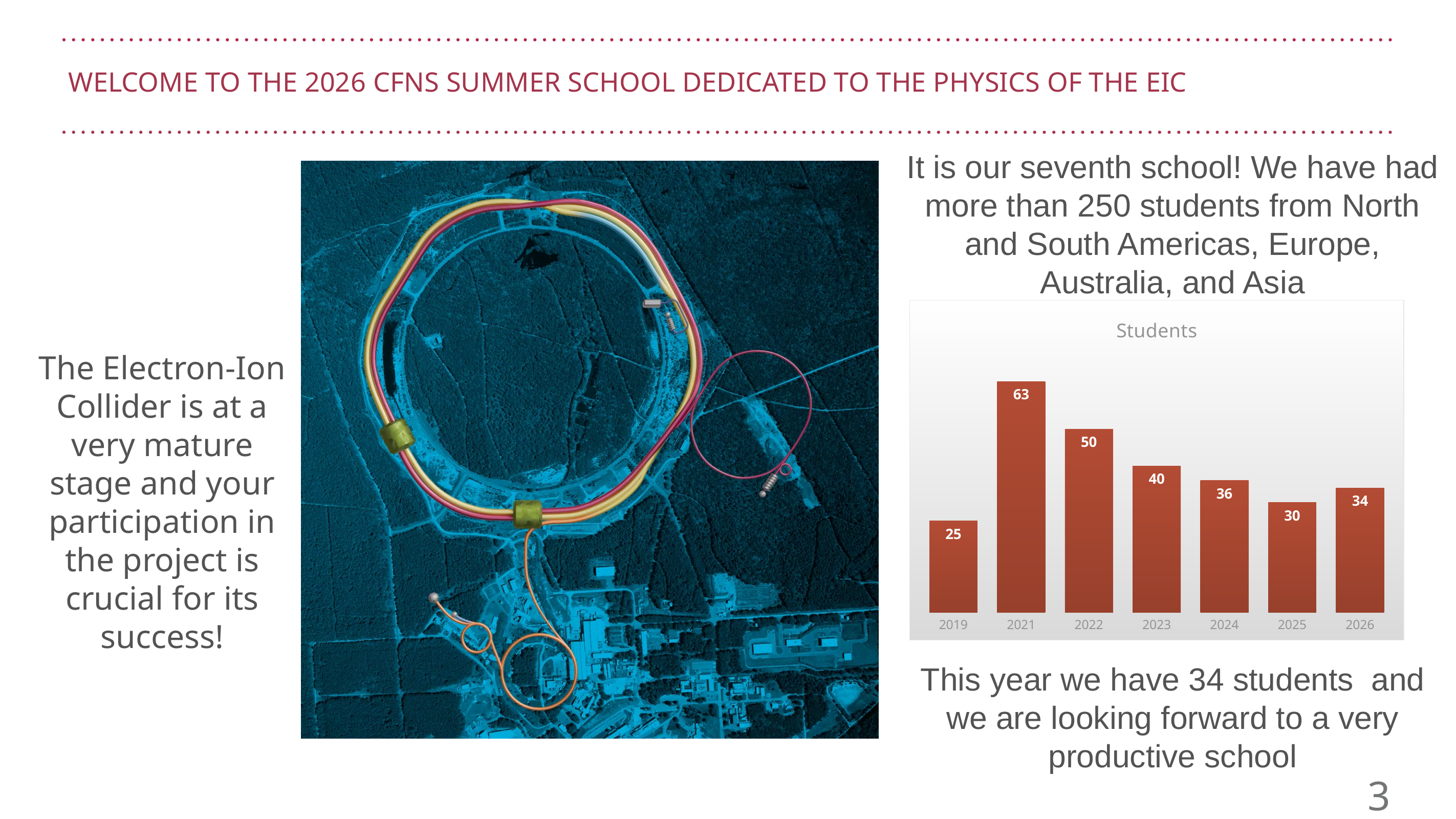
What is the title of the chart on the slide? Students Which year has the lowest value in the Students chart? 2019 How many years are shown in the Students chart? 7 What is the value for 2021 in the Students chart? 63 What is the difference between the values for 2026 and 2025 in the Students chart? 4 What is the value for 2026 in the Students chart? 34 Which year has the highest value in the Students chart? 2021 Which is larger in the Students chart, the value for 2024 or the value for 2025? 2024 What is the value for 2019 in the Students chart? 25 What is the difference between the values for 2021 and 2022 in the Students chart? 13 What kind of chart is the Students chart? bar chart Do the values in the Students chart rise or fall from 2021 to 2025? fall